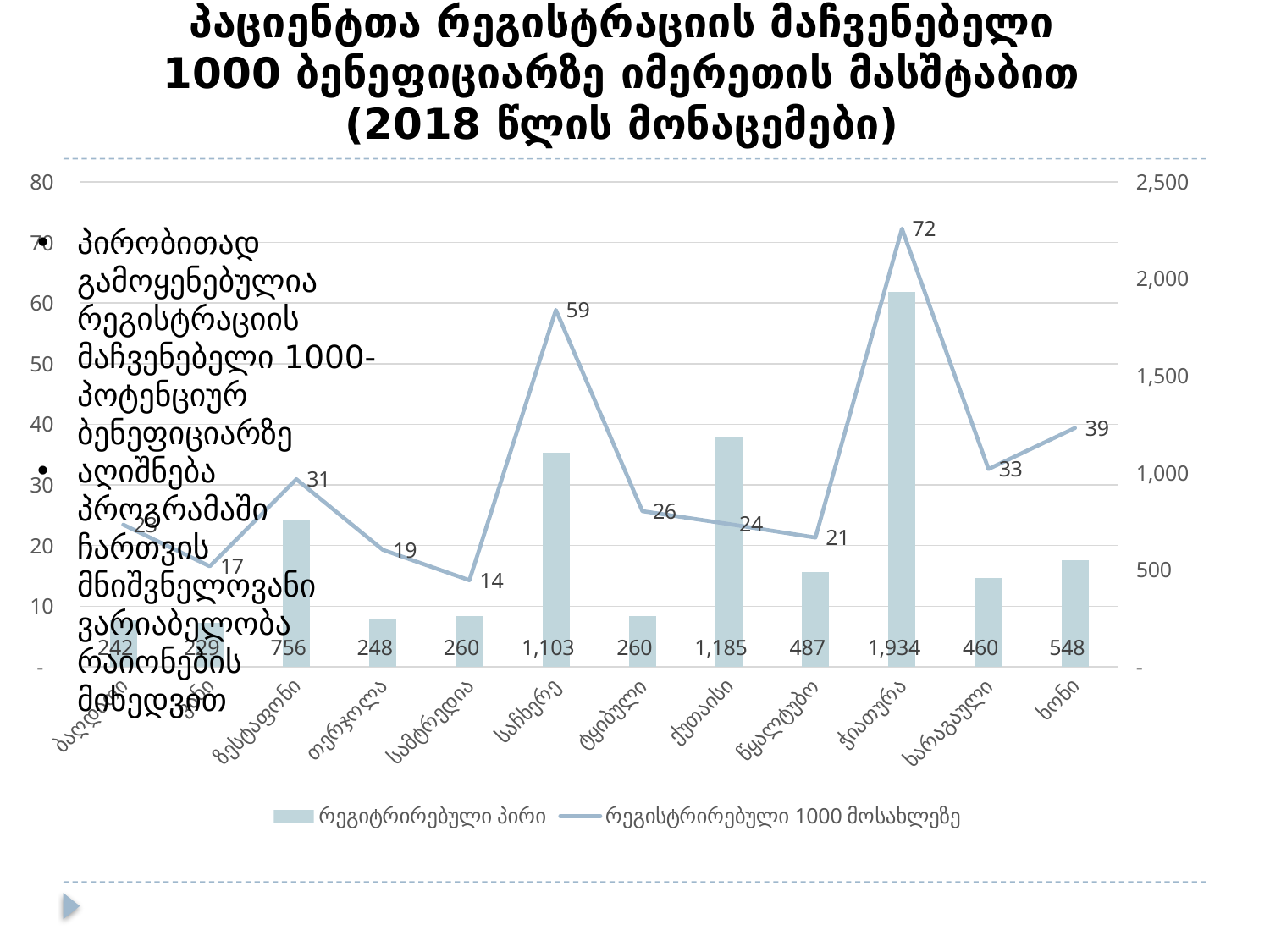
Which has a higher value of რეგიტრირებული პირი, ხონი or ხარაგაული? ხონი How many categories are shown on the x axis of the chart? 12 What is the value of რეგიტრირებული პირი for წყალტუბო? 487 What is the difference in რეგიტრირებული პირი between ქუთაისი and საჩხერე? 82 Which category has the highest value of რეგისტრირებული 1000 მოსახლეზე? ჭიათურა Which category has the lowest value of რეგისტრირებული 1000 მოსახლეზე? სამტრედია What is the difference in რეგისტრირებული 1000 მოსახლეზე between ჭიათურა and ხარაგაული? 39 How many series does the legend list? 2 Which category has the highest value of რეგიტრირებული პირი? ჭიათურა What is the value of რეგისტრირებული 1000 მოსახლეზე for საჩხერე? 59 What is the value of რეგიტრირებული პირი for ჭიათურა? 1,934 What is the value of რეგისტრირებული 1000 მოსახლეზე for ხონი? 39